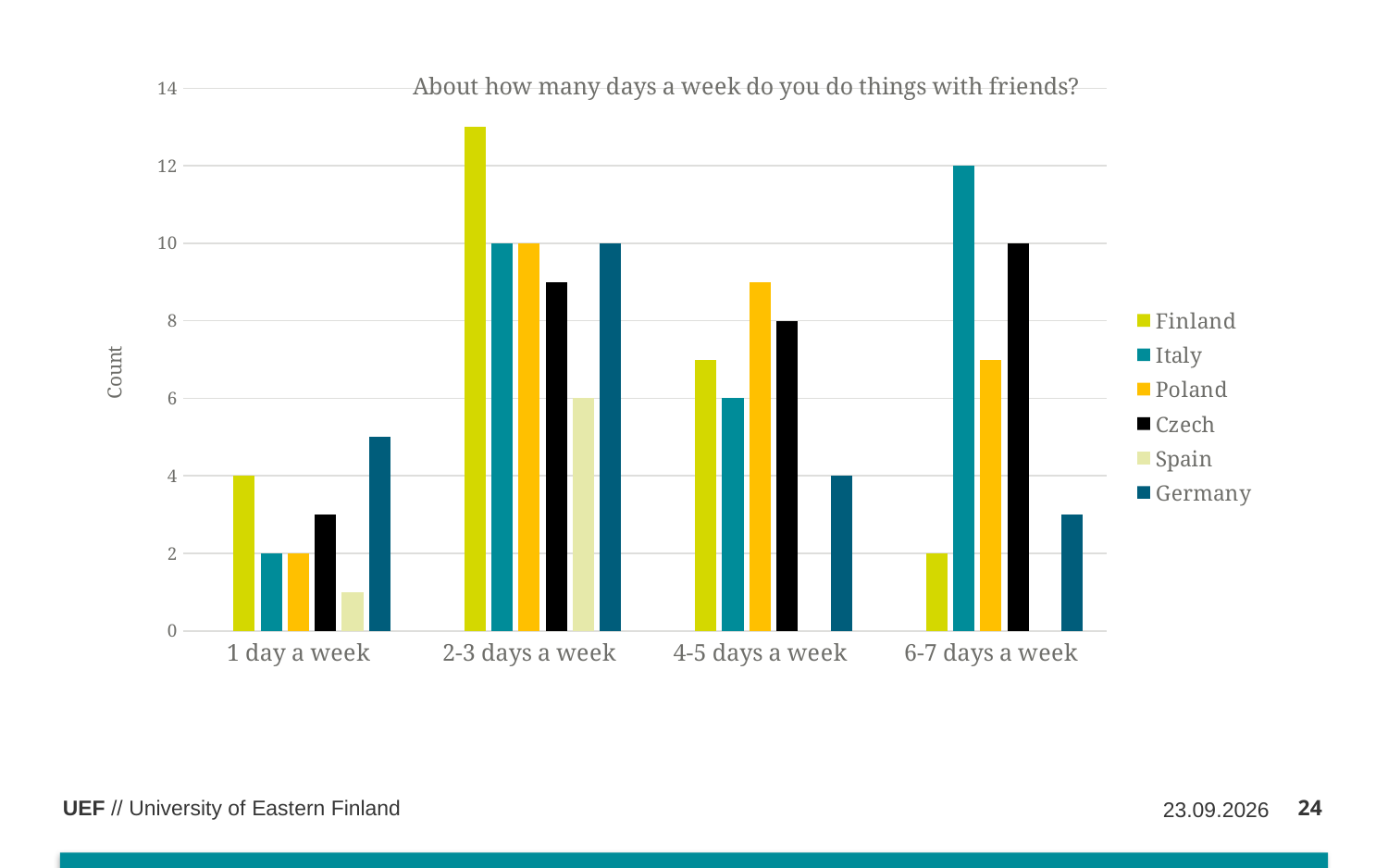
Which country has the highest count in the '2-3 days a week' category? Finland What is the title of the chart? About how many days a week do you do things with friends? In the '6-7 days a week' category, which is larger: the count for Italy or the count for Czech? Italy How many series does the legend list? 6 What is the count for Italy in the '6-7 days a week' category? 12 What kind of chart is shown on the slide? bar chart How many categories are shown on the x axis? 4 What is the count for Czech in the '4-5 days a week' category? 8 What is the count for Germany in the '2-3 days a week' category? 10 Is the value for Finland in the '2-3 days a week' category greater or less than 12? greater Which country has the lowest count in the '1 day a week' category? Spain What is the count for Finland in the '1 day a week' category? 4